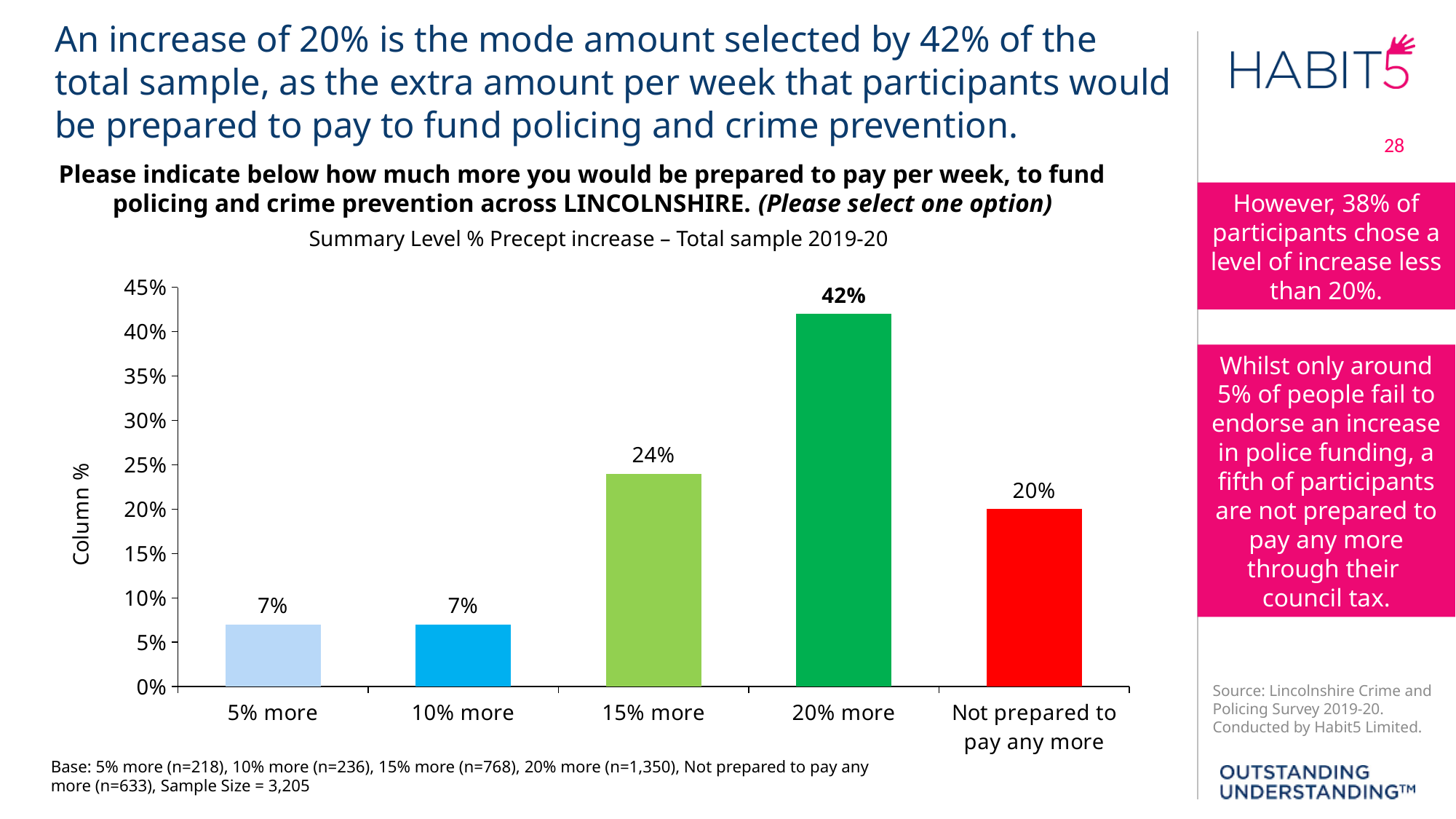
Is the value for '20% more' greater or less than 40%? greater What percentage of participants selected '20% more'? 42% Which is larger, the value for '15% more' or the value for 'Not prepared to pay any more'? 15% more Which category has the highest value? 20% more What is the label of the y axis? Column % What is the chart's title? Summary Level % Precept increase – Total sample 2019-20 What kind of chart is shown on the slide? bar chart What is the value for 'Not prepared to pay any more'? 20% How many categories are shown on the x axis? 5 What is the difference between the values for 'Not prepared to pay any more' and '5% more'? 13% What percentage of participants selected '15% more'? 24% What is the difference between the values for '20% more' and '15% more'? 18%